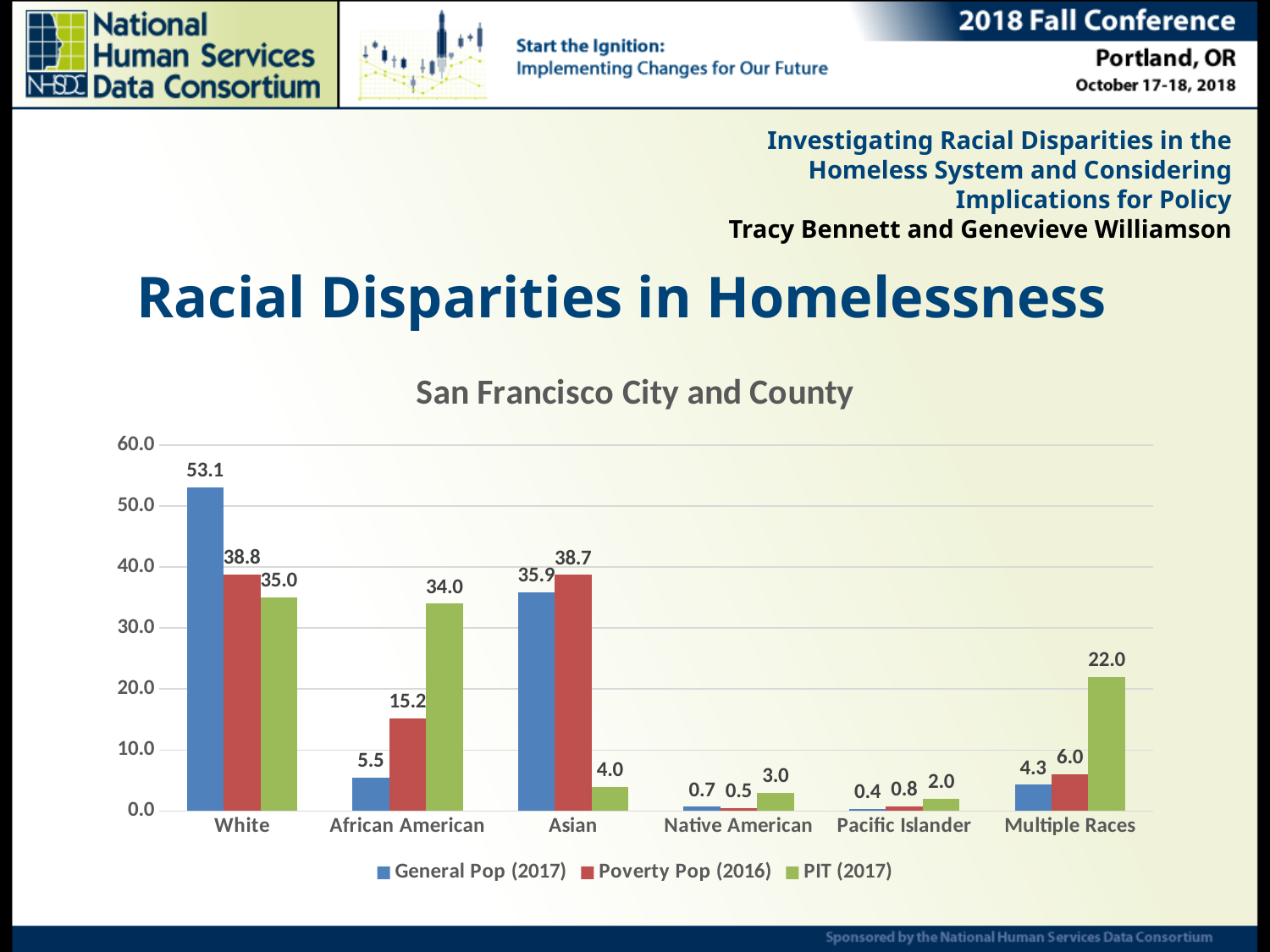
Which category has the lowest General Pop (2017) value? Pacific Islander Which category has the highest PIT (2017) value? White What is the Poverty Pop (2016) value for Asian? 38.7 What type of chart is shown on the slide? Bar chart What is the PIT (2017) value for Multiple Races? 22.0 What is the PIT (2017) value for African American? 34.0 How many categories are shown on the x axis? 6 What is the difference between the General Pop (2017) and PIT (2017) values for Asian? 31.9 For African American, which is larger: the Poverty Pop (2016) value or the PIT (2017) value? PIT (2017) What is the General Pop (2017) value for White? 53.1 How many series does the legend list? 3 Is the General Pop (2017) value for White greater or less than 50.0? greater